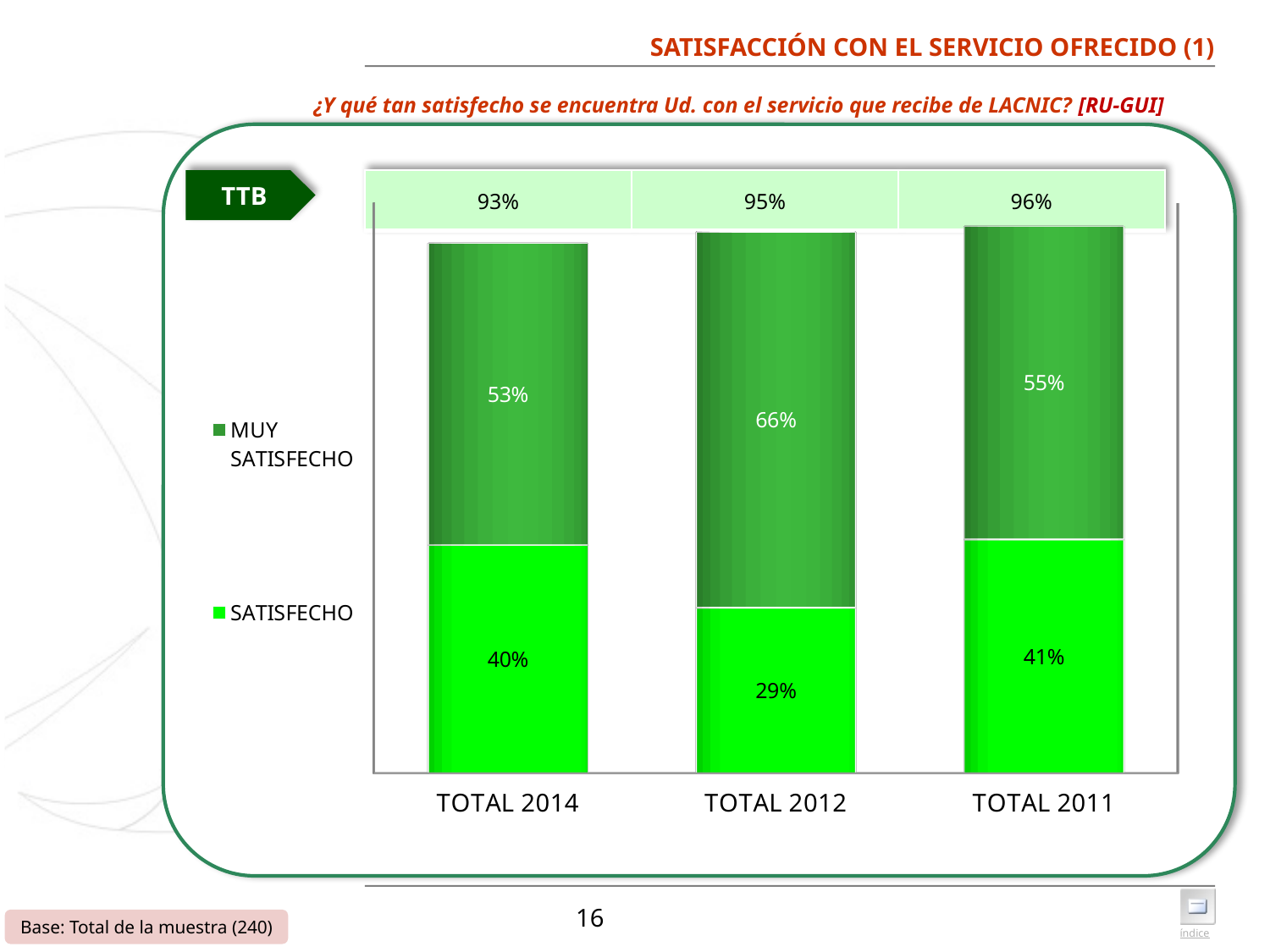
What is the SATISFECHO value for TOTAL 2011? 41% What is the TTB value shown for TOTAL 2011? 96% What is the total of the stacked bar for TOTAL 2014 (MUY SATISFECHO plus SATISFECHO)? 93% How many series does the legend list? 2 Which category has the lowest SATISFECHO value? TOTAL 2012 What kind of chart is shown on the slide? Stacked bar chart What is the MUY SATISFECHO value for TOTAL 2012? 66% Which is larger: the SATISFECHO value for TOTAL 2014 or for TOTAL 2011? TOTAL 2011 Which category has the highest MUY SATISFECHO value? TOTAL 2012 What is the SATISFECHO value for TOTAL 2014? 40% What is the difference between the MUY SATISFECHO values for TOTAL 2012 and TOTAL 2014? 13% How many categories are shown on the x axis? 3